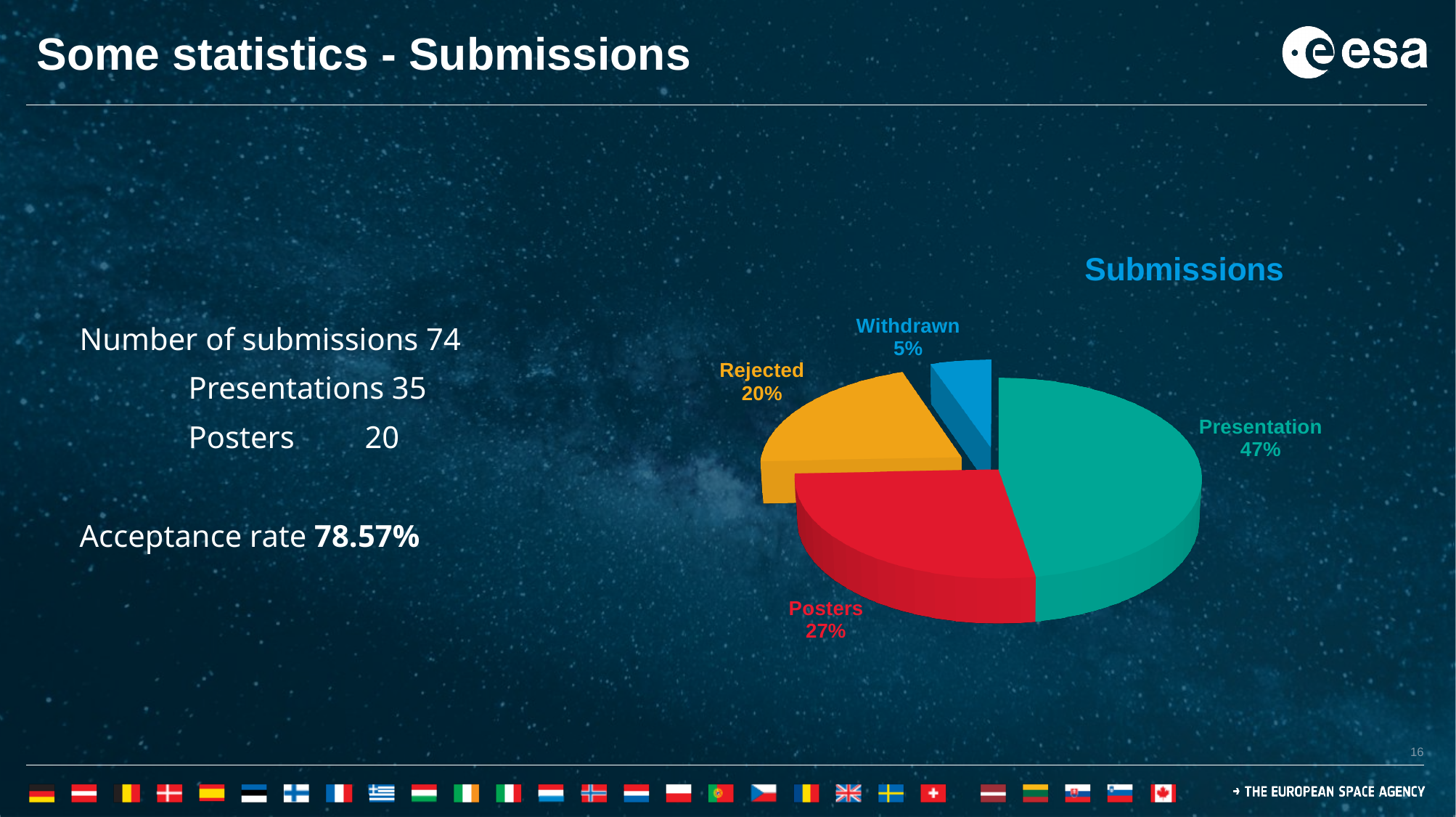
Which slice is larger, Rejected or Posters? Posters How many slices does the pie chart have? 4 What is the difference in percentage points between the Presentation and Posters slices? 20 What share of the pie is Withdrawn? 5% What is the title of the chart? Submissions Which category has the smallest slice of the pie? Withdrawn What kind of chart is shown on the slide? pie chart What share of the pie is Presentation? 47% Which category has the largest slice of the pie? Presentation What share of the pie is Posters? 27% What colour is the Rejected slice? orange